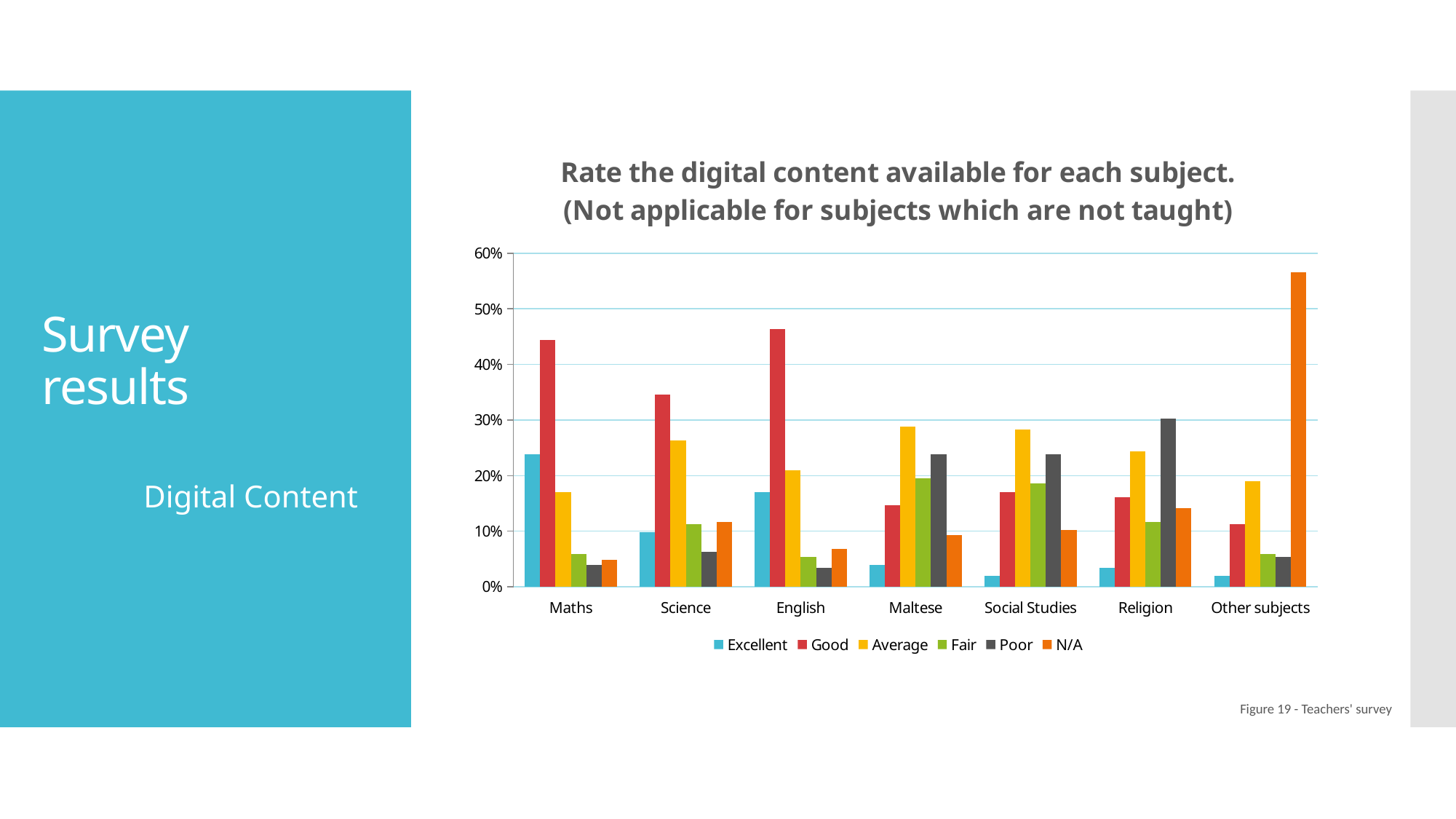
For Religion, which is larger: the Poor value or the Excellent value? Poor Is the Average value for Science greater or less than 20%? greater Which subject has the highest N/A value? Other subjects What kind of chart is shown on the slide? Bar chart For Maltese, which is larger: the Average value or the Good value? Average Which series in the legend is shown in orange? N/A How many subjects are shown on the x axis of the chart? 7 Is the N/A value for Other subjects greater or less than 50%? greater How many series does the chart's legend list? 6 Which subject has the lowest Good value? Other subjects Which subject has the highest Excellent value? Maths Is the Good value for Maths greater or less than 40%? greater